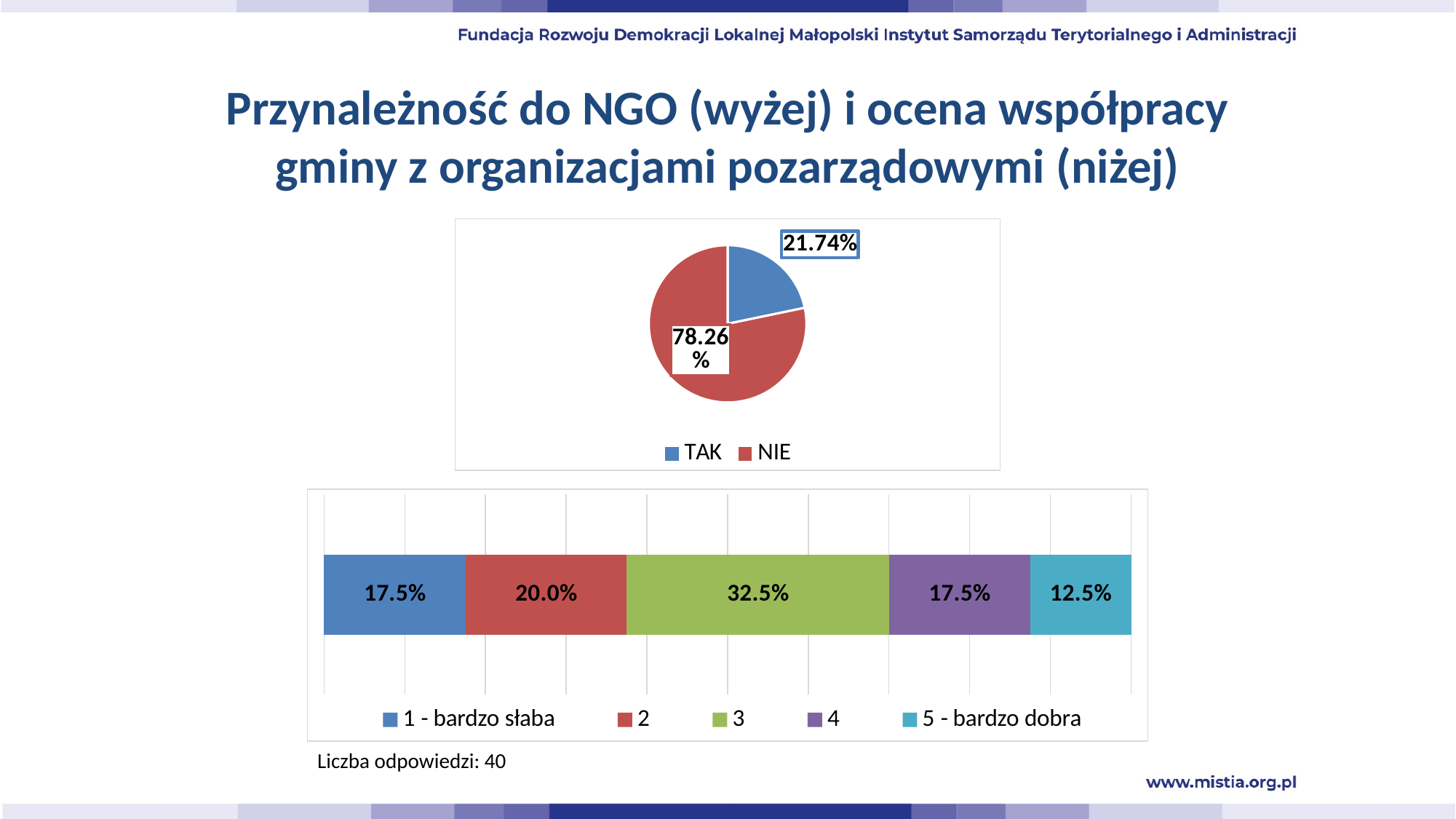
In the lower bar chart, which rating has the highest value? 3 In the upper pie chart, what share of respondents answered NIE? 78.26% How many entries does the legend of the upper pie chart list? 2 What kind of chart is the upper chart on the slide? Pie chart In the upper pie chart, which answer has the larger share, TAK or NIE? NIE In the upper pie chart, what share of respondents answered TAK? 21.74% In the lower bar chart, what is the difference between the value for rating 3 and the value for rating 2? 12.5% How many series does the legend of the lower bar chart list? 5 In the lower bar chart, which rating has the lowest value? 5 - bardzo dobra What kind of chart is the lower chart on the slide? Stacked bar chart In the lower bar chart, what is the value for '5 - bardzo dobra'? 12.5% In the lower bar chart, what is the value for the rating 3? 32.5%